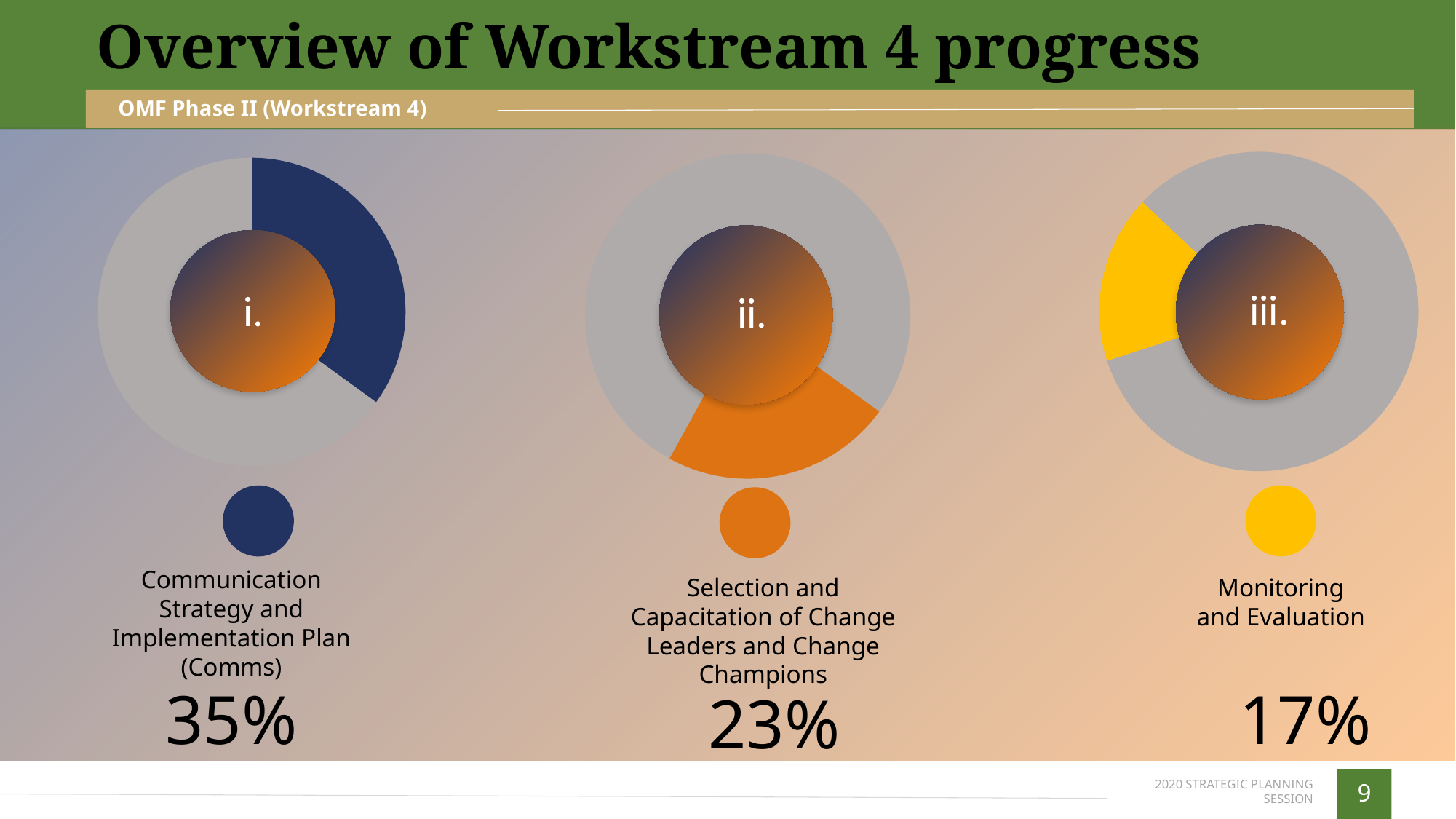
What is the difference in progress between the Comms chart and the Selection and Capacitation of Change Leaders and Change Champions chart? 12% Which of the three workstream items shows the highest progress percentage? Communication Strategy and Implementation Plan (Comms) What percentage progress is shown for the Communication Strategy and Implementation Plan (Comms) chart? 35% Which shows a larger progress percentage: the Selection and Capacitation of Change Leaders chart or the Monitoring and Evaluation chart? Selection and Capacitation of Change Leaders and Change Champions What is the difference in progress between the Selection and Capacitation of Change Leaders chart and the Monitoring and Evaluation chart? 6% What percentage progress is shown for the Selection and Capacitation of Change Leaders and Change Champions chart? 23% What is the difference in progress between the Comms chart and the Monitoring and Evaluation chart? 18% What percentage progress is shown for the Monitoring and Evaluation chart? 17% Which of the three workstream items shows the lowest progress percentage? Monitoring and Evaluation What kind of chart is used to show each workstream item's progress? Doughnut chart What colour is the filled segment in the Monitoring and Evaluation chart? Yellow How many progress charts are shown on the slide? 3